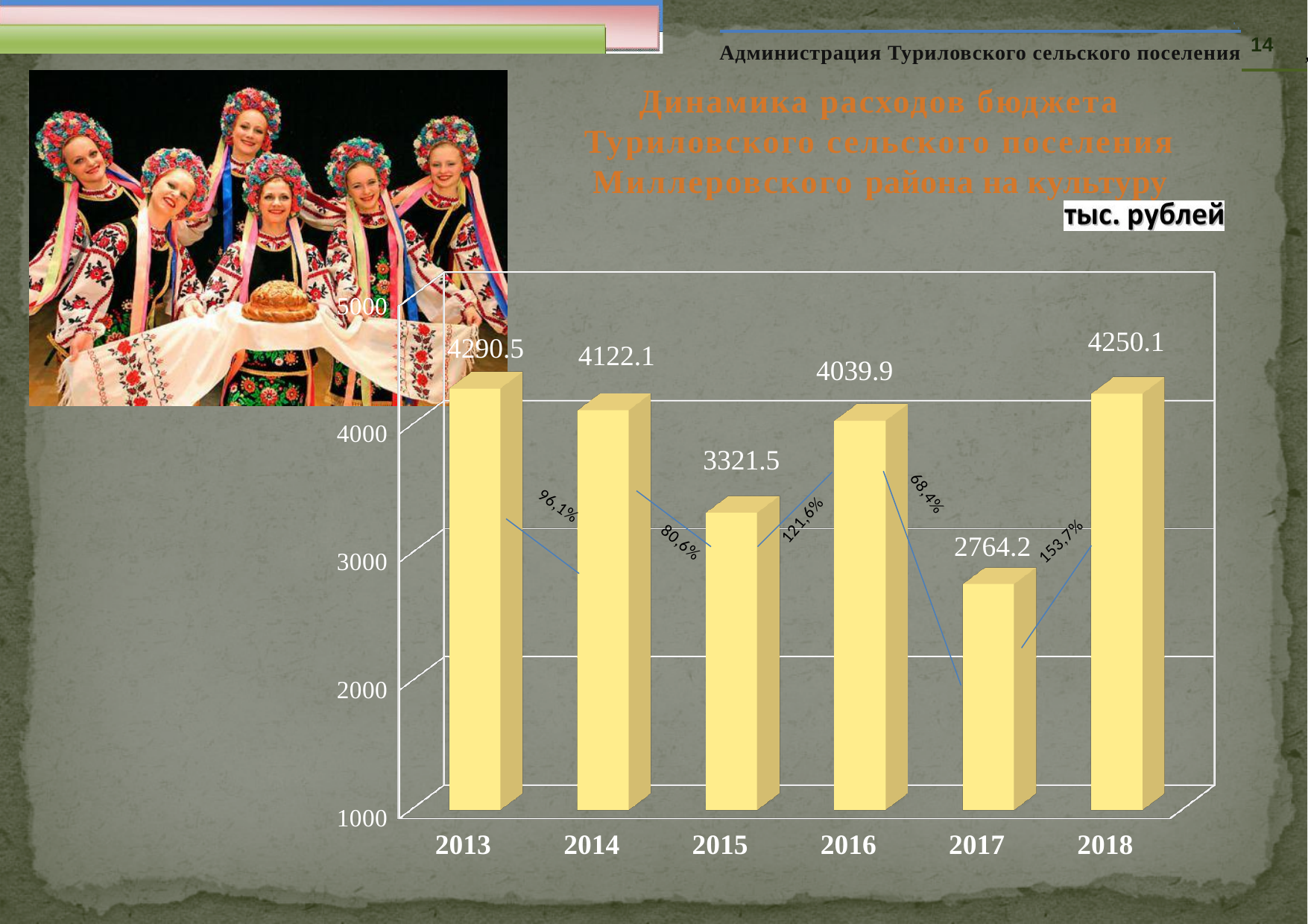
Which year has the highest value? 2013 How many years are shown on the x axis? 6 What is the value for 2017? 2764.2 What kind of chart is shown on the slide? bar chart Which year has the lowest value? 2017 What unit is stated for the chart values? тыс. рублей Which is larger, the value for 2015 or the value for 2016? 2016 What is the value for 2018? 4250.1 What is the difference between the values for 2013 and 2017? 1526.3 What is the value for 2013? 4290.5 Is the value for 2015 greater or less than 3000? greater What percentage label is shown between the 2017 and 2018 bars? 153,7%